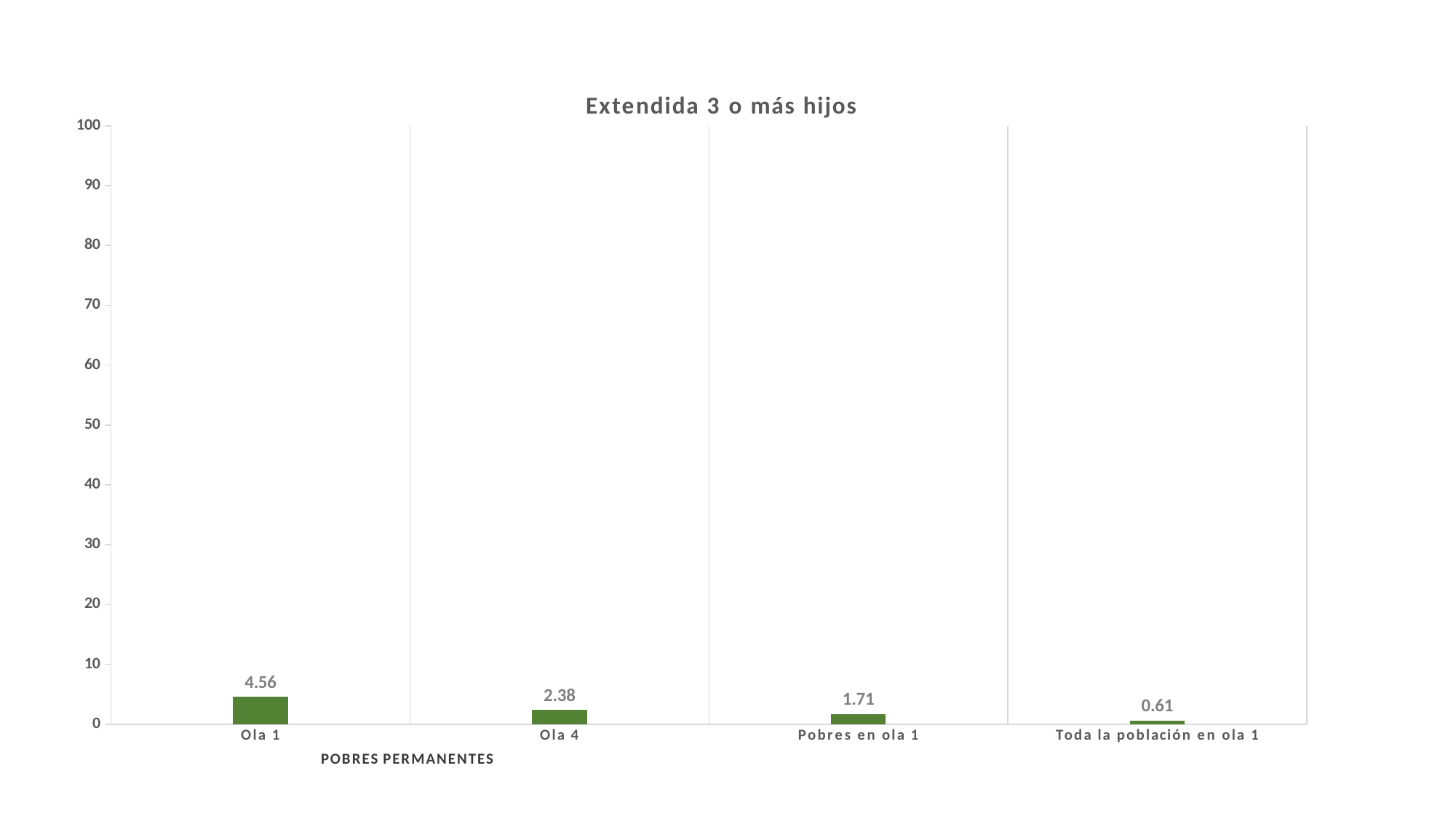
What is the value for Ola 4? 2.38 Which category has the highest value? Ola 1 What is the value for Ola 1? 4.56 What is the difference between the values for Ola 1 and Ola 4? 2.18 How many categories are shown on the x axis? 4 What is the title of the chart? Extendida 3 o más hijos What is the value for Toda la población en ola 1? 0.61 What kind of chart is this? bar chart Which is larger, the value for Ola 4 or the value for Pobres en ola 1? Ola 4 What is the value for Pobres en ola 1? 1.71 Is the value for Ola 1 greater or less than 10? less Which category has the lowest value? Toda la población en ola 1